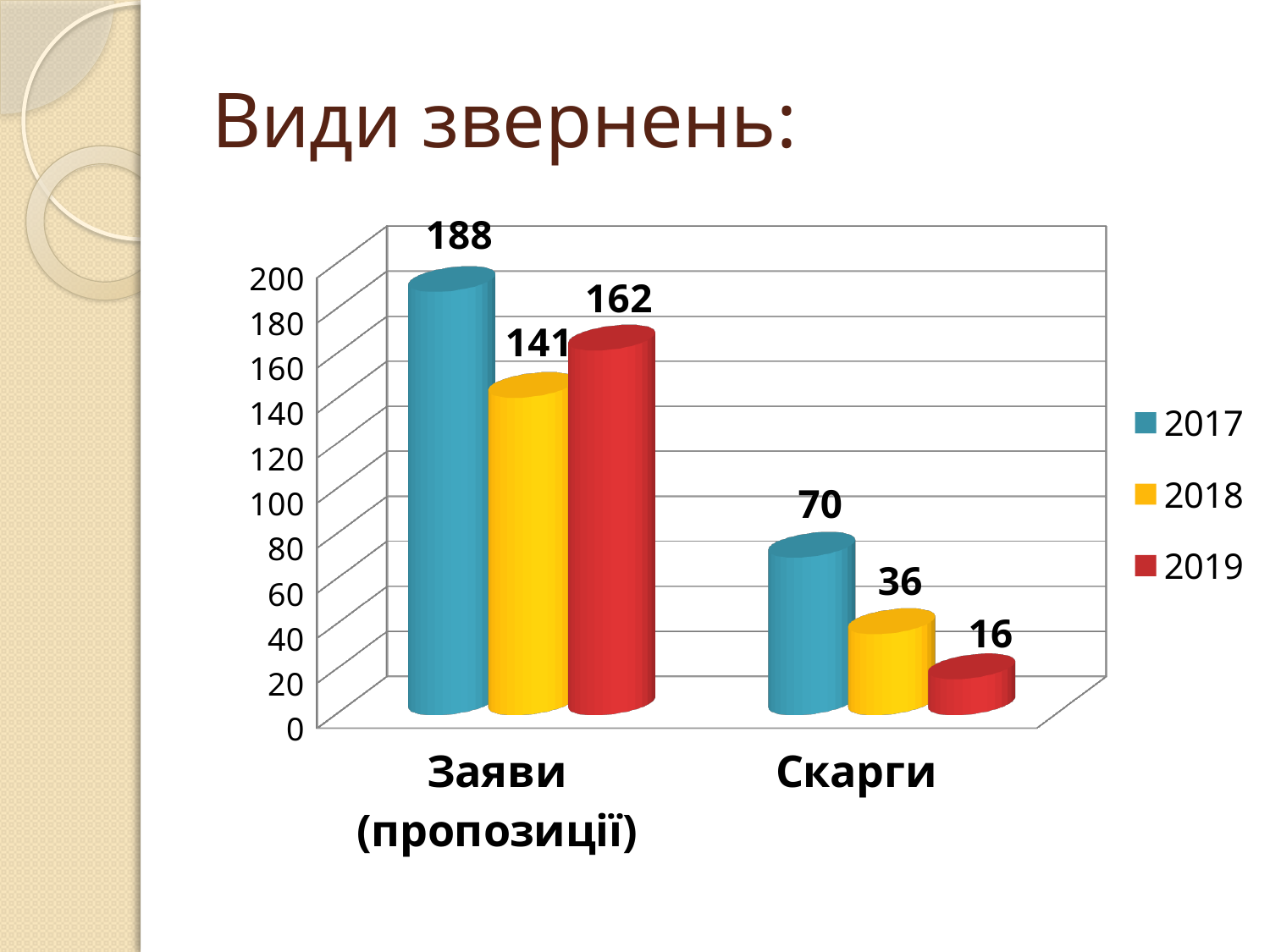
What is the difference between the 2017 and 2019 values in the Скарги category? 54 How many series does the legend list? 3 What is the value for 2017 in the Заяви (пропозиції) category? 188 What is the title of the slide? Види звернень: How many categories are shown on the x axis? 2 Which is larger: the 2018 value for Заяви (пропозиції) or the 2019 value for Заяви (пропозиції)? 2019 value for Заяви (пропозиції) What is the value for 2019 in the Заяви (пропозиції) category? 162 What is the difference between the 2017 and 2019 values in the Заяви (пропозиції) category? 26 What is the value for 2018 in the Скарги category? 36 Which year has the lowest value in the Заяви (пропозиції) category? 2018 What kind of chart is shown on the slide? Bar chart Which year has the highest value in the Скарги category? 2017